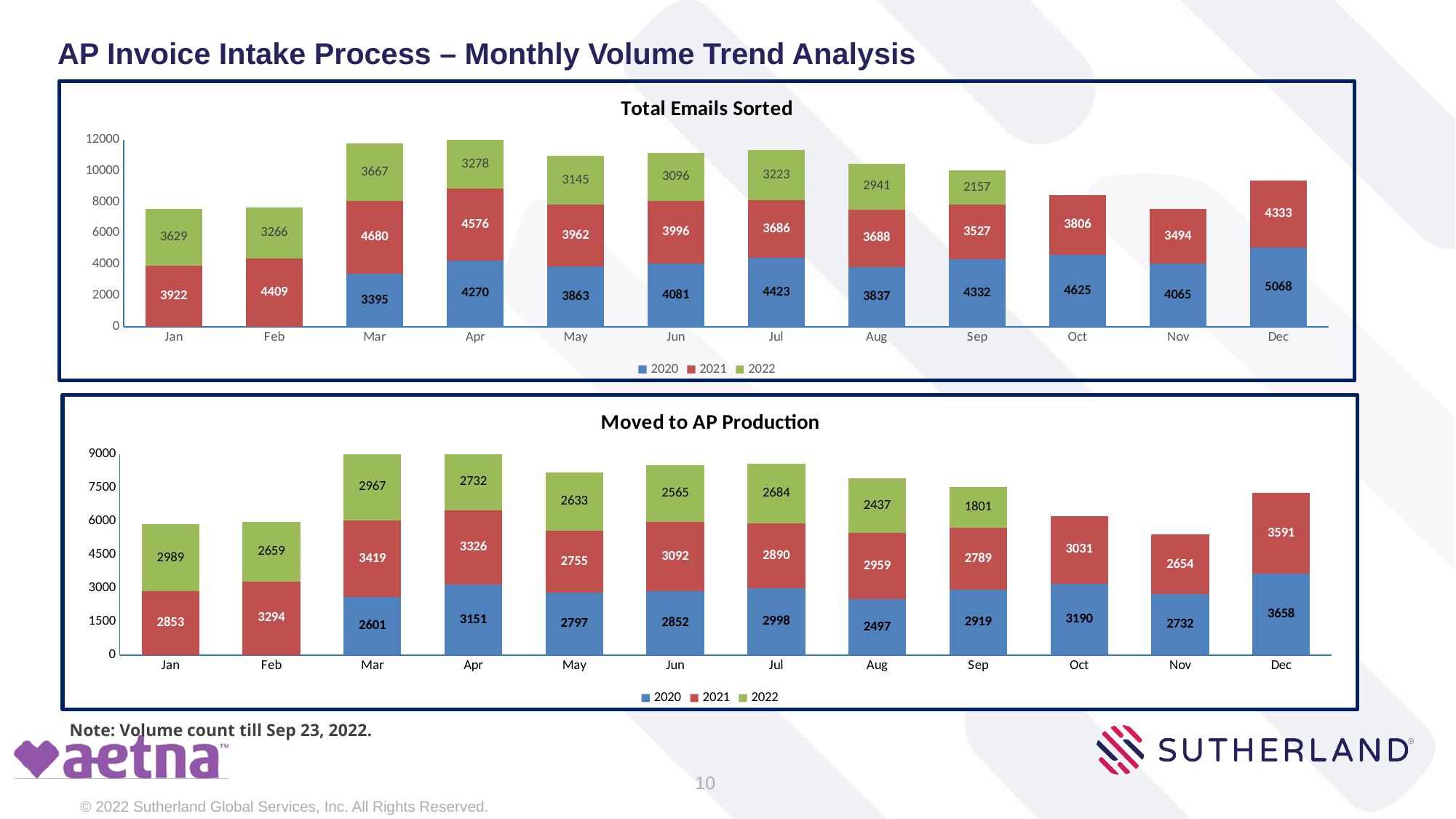
How many series does the legend of the Total Emails Sorted chart list? 3 In the Total Emails Sorted chart, what is the value for 2021 in Mar? 4680 In the Total Emails Sorted chart, what is the total of the stacked bar for Mar? 11742 In the Moved to AP Production chart, what is the total of the stacked bar for Dec? 7249 In the Total Emails Sorted chart, what is the value for 2020 in Dec? 5068 In the Moved to AP Production chart, which is larger in Apr: the 2021 value or the 2022 value? 2021 What kind of chart is the Moved to AP Production chart? Stacked bar chart In the Total Emails Sorted chart, which month has the highest 2020 value? Dec In the Moved to AP Production chart, what is the value for 2020 in Oct? 3190 In the Moved to AP Production chart, what is the value for 2022 in Sep? 1801 In the Moved to AP Production chart, which month has the lowest 2022 value? Sep In the Total Emails Sorted chart, what is the difference between the 2020 and 2021 values in Dec? 735